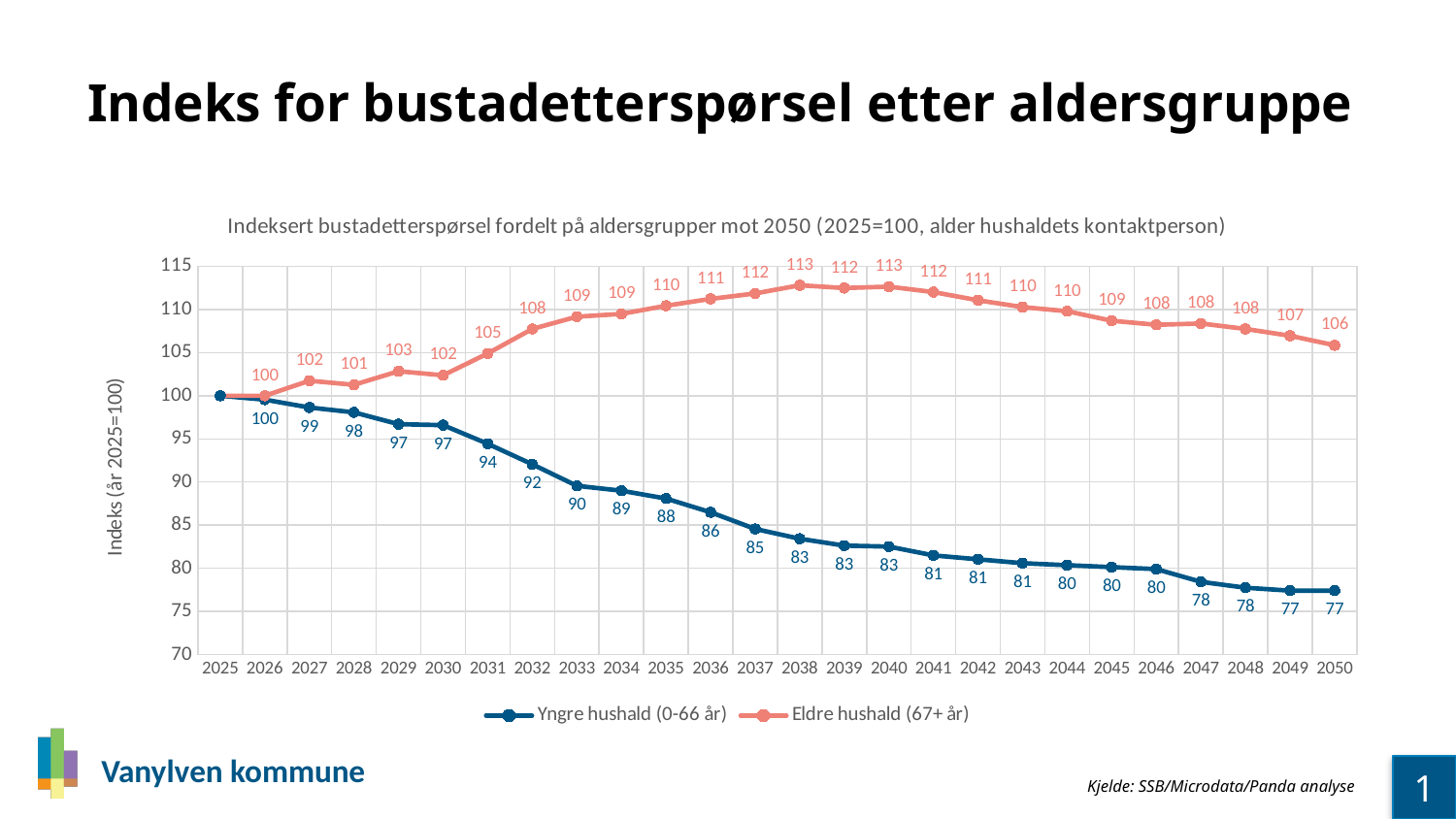
Does the Yngre hushald (0-66 år) series rise or fall from 2025 to 2050? Fall What is the value for Eldre hushald (67+ år) in 2032? 108 What is the value for Yngre hushald (0-66 år) in 2040? 83 What is the difference between Eldre hushald (67+ år) and Yngre hushald (0-66 år) in 2050? 29 How many years are plotted on the x axis? 26 What is the highest value reached by the Eldre hushald (67+ år) series? 113 How many series does the legend list? 2 Is the value for Yngre hushald (0-66 år) in 2036 greater or less than 90? less What is the value for Eldre hushald (67+ år) in 2050? 106 What kind of chart is shown on the slide? Line chart What is the lowest value reached by the Yngre hushald (0-66 år) series? 77 In 2045, which series has the higher value, Yngre hushald (0-66 år) or Eldre hushald (67+ år)? Eldre hushald (67+ år)